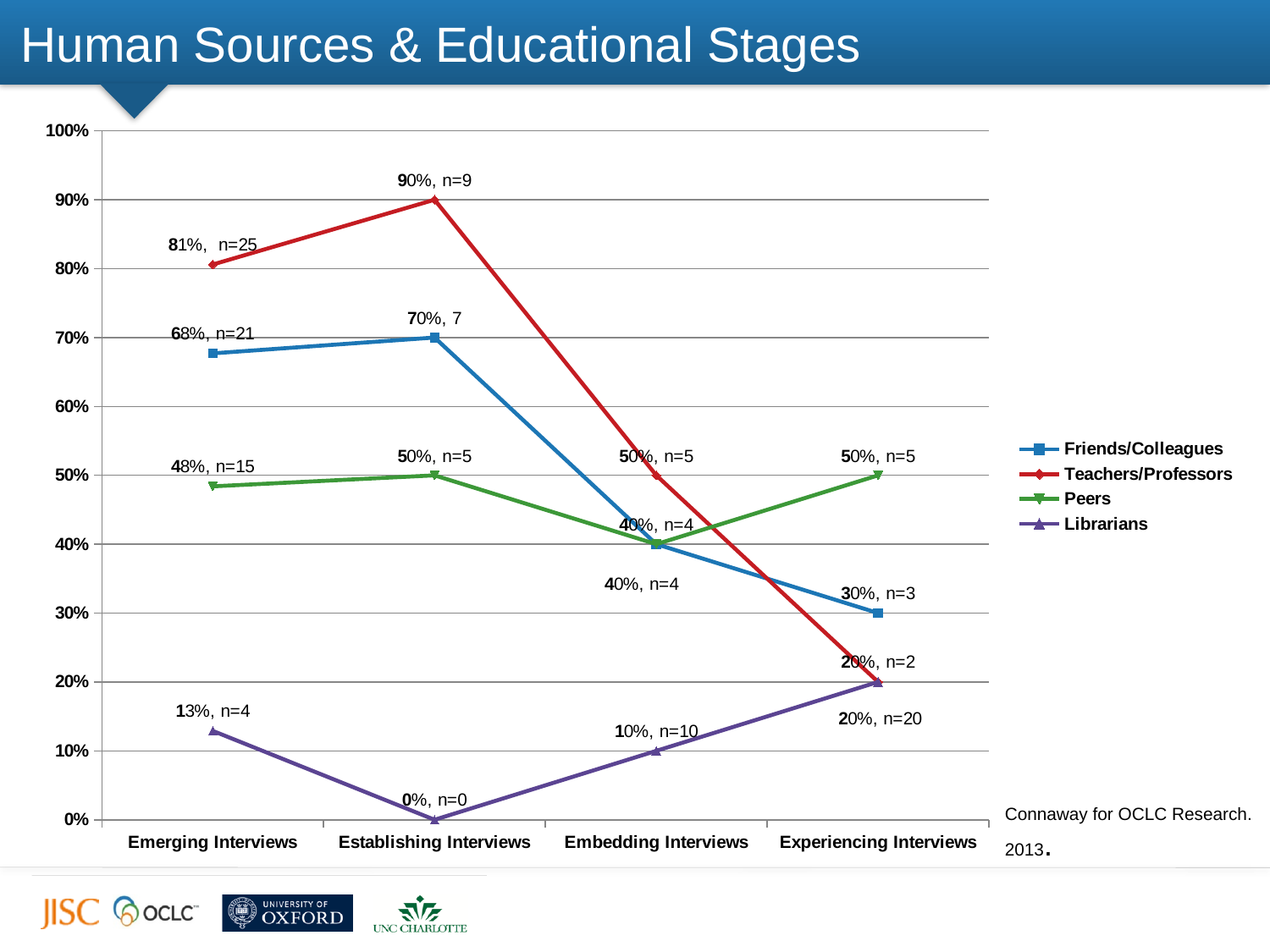
At which interview stage does Teachers/Professors reach its highest value? Establishing Interviews How many series does the legend list? 4 What kind of chart is shown on the slide? Line chart What is the value for Librarians at Experiencing Interviews? 20% What is the value for Teachers/Professors at Establishing Interviews? 90% How many interview stages are shown along the x axis? 4 Is the value for Friends/Colleagues at Experiencing Interviews greater or less than 40%? less What is the n value shown for Teachers/Professors at Emerging Interviews? n=25 What is the difference between the Teachers/Professors value at Establishing Interviews and at Experiencing Interviews? 70 percentage points At Emerging Interviews, which is larger: Teachers/Professors or Friends/Colleagues? Teachers/Professors At which interview stage does Librarians have its lowest value? Establishing Interviews Does the Teachers/Professors line rise or fall from Establishing Interviews to Experiencing Interviews? Fall